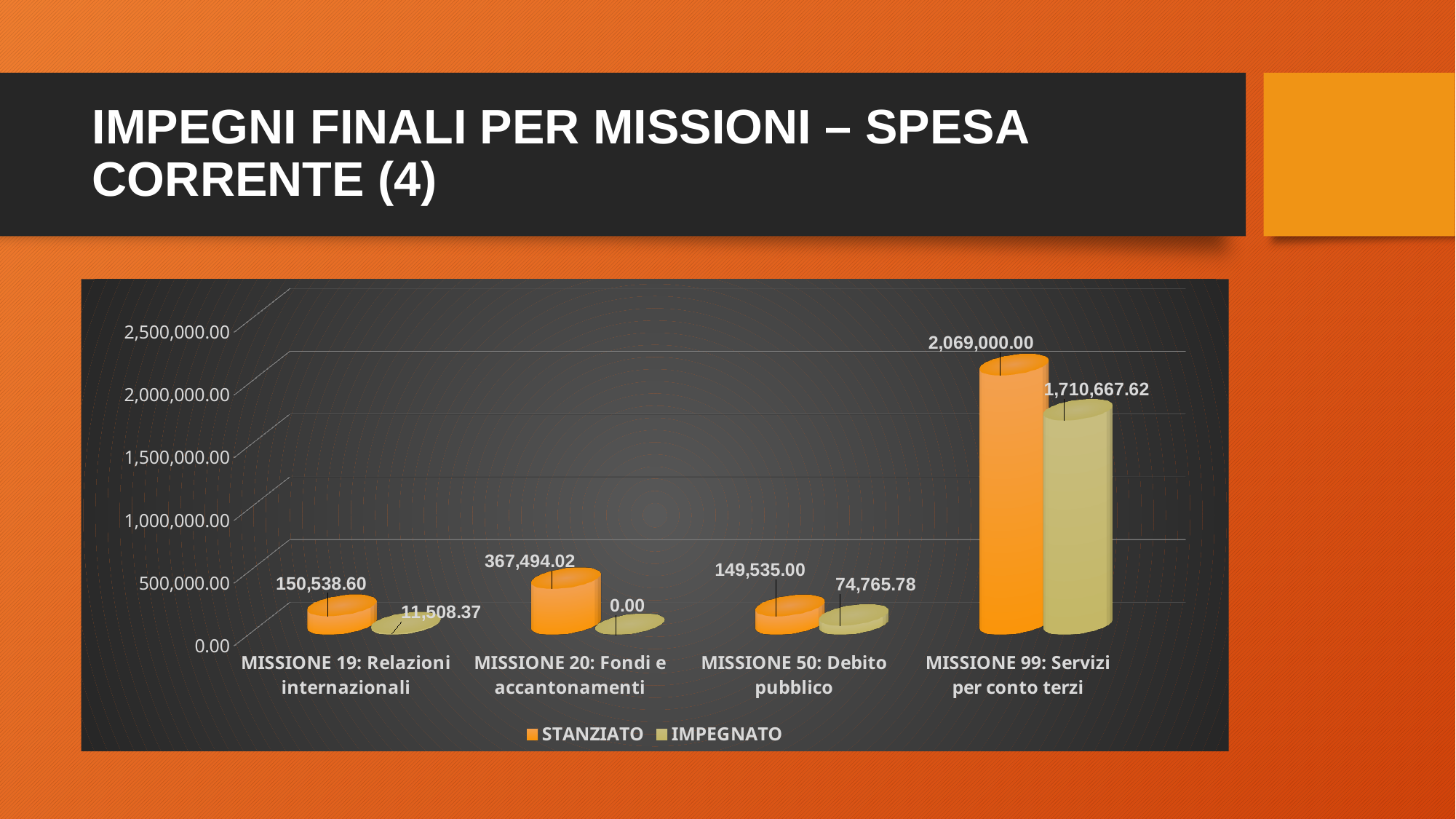
What is the difference between the STANZIATO and IMPEGNATO values for MISSIONE 99: Servizi per conto terzi? 358,332.38 Which is larger: the STANZIATO value for MISSIONE 20: Fondi e accantonamenti or the STANZIATO value for MISSIONE 19: Relazioni internazionali? MISSIONE 20: Fondi e accantonamenti What is the IMPEGNATO value for MISSIONE 50: Debito pubblico? 74,765.78 What is the STANZIATO value for MISSIONE 19: Relazioni internazionali? 150,538.60 Which mission has the highest IMPEGNATO value? MISSIONE 99: Servizi per conto terzi How many series does the chart legend list? 2 What is the IMPEGNATO value for MISSIONE 20: Fondi e accantonamenti? 0.00 Which mission has the lowest STANZIATO value? MISSIONE 50: Debito pubblico How many missions are shown on the x axis of the chart? 4 What kind of chart is shown on the slide? Bar chart What is the difference between the STANZIATO and IMPEGNATO values for MISSIONE 50: Debito pubblico? 74,769.22 What is the STANZIATO value for MISSIONE 99: Servizi per conto terzi? 2,069,000.00